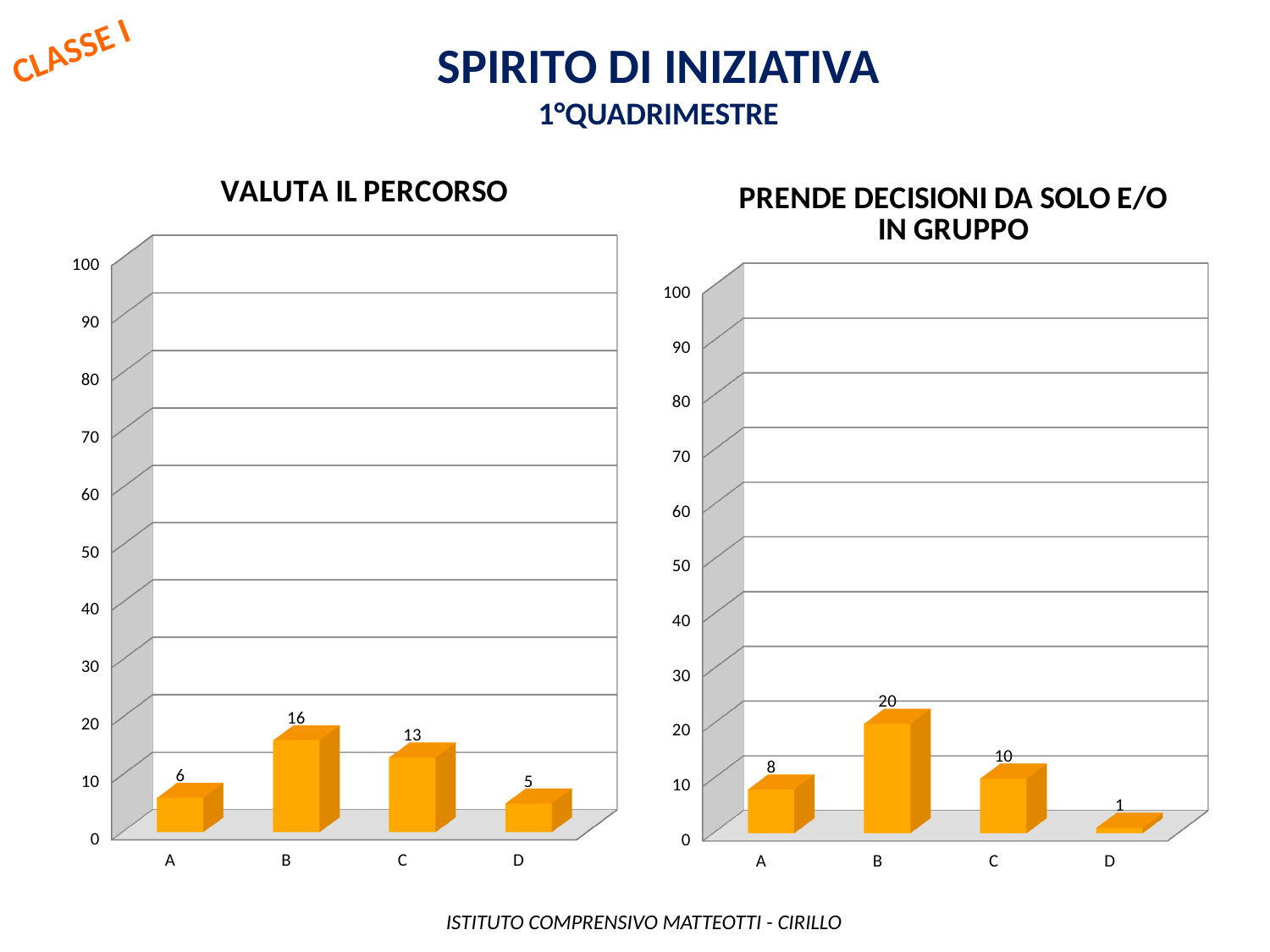
In the 'PRENDE DECISIONI DA SOLO E/O IN GRUPPO' chart, is the value for B greater or less than 10? greater What kind of chart is the 'PRENDE DECISIONI DA SOLO E/O IN GRUPPO' chart? bar chart In the 'PRENDE DECISIONI DA SOLO E/O IN GRUPPO' chart, what is the difference between the values for B and A? 12 In the 'PRENDE DECISIONI DA SOLO E/O IN GRUPPO' chart, what is the value for category D? 1 In the 'PRENDE DECISIONI DA SOLO E/O IN GRUPPO' chart, what is the value for category A? 8 In the 'VALUTA IL PERCORSO' chart, which category has the highest value? B How many categories are shown in the 'VALUTA IL PERCORSO' chart? 4 In the 'PRENDE DECISIONI DA SOLO E/O IN GRUPPO' chart, which category has the lowest value? D In the 'VALUTA IL PERCORSO' chart, what is the difference between the values for B and C? 3 In the 'VALUTA IL PERCORSO' chart, what is the value for category B? 16 In the 'VALUTA IL PERCORSO' chart, which is larger, the value for A or the value for C? C In the 'VALUTA IL PERCORSO' chart, what is the value for category D? 5